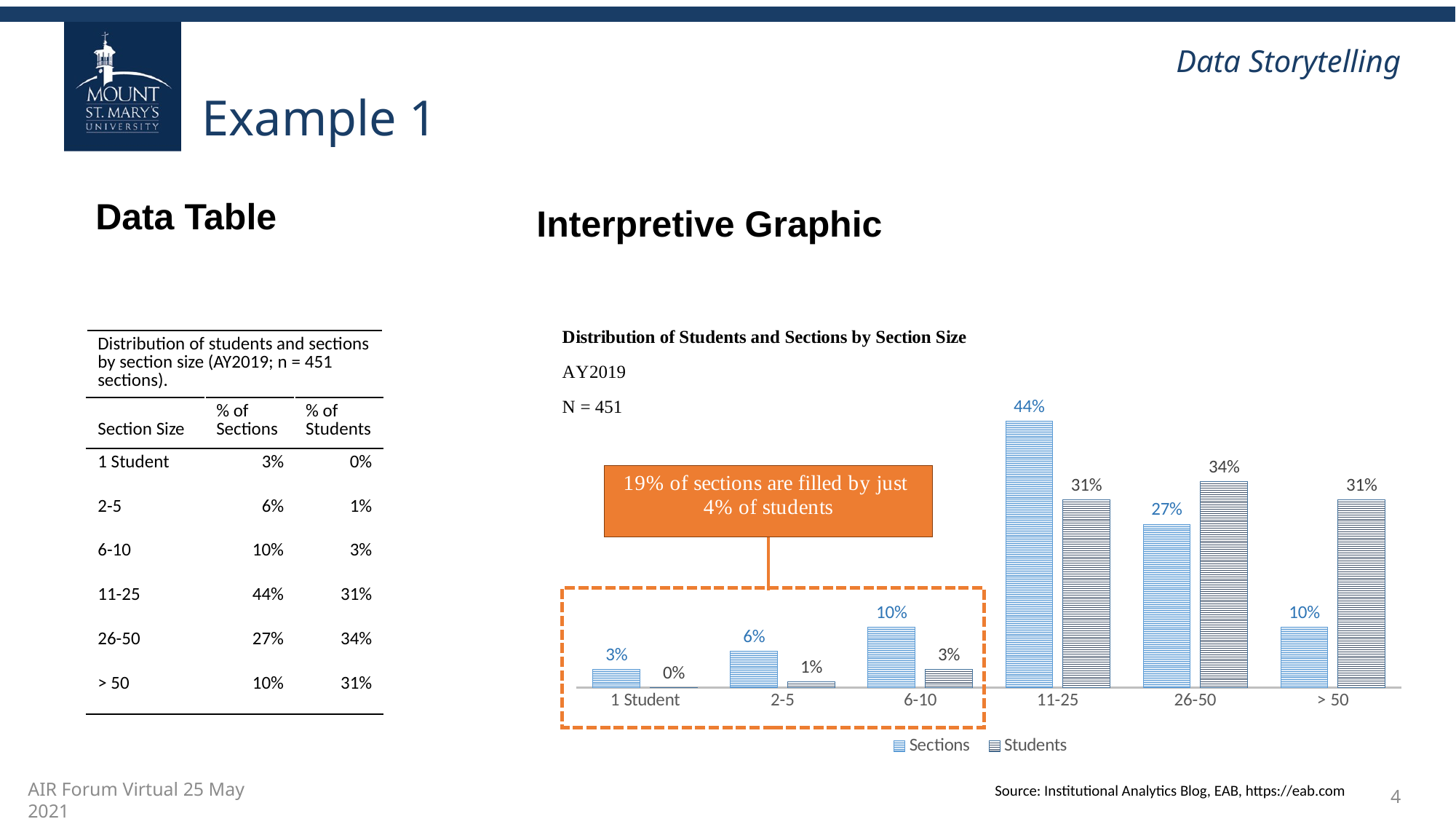
For the > 50 section size, which is larger: the percentage of sections or the percentage of students? Students What is the title of the chart? Distribution of Students and Sections by Section Size What is the difference between the percentage of sections and the percentage of students for the 11-25 section size? 13% How many series does the chart legend list? 2 What does the orange callout box on the chart say? 19% of sections are filled by just 4% of students What kind of chart is shown under Interpretive Graphic? Bar chart How many section size categories are shown on the x axis of the chart? 6 Which section size has the highest percentage of sections? 11-25 Which section size has the lowest percentage of students? 1 Student What percentage of students are in sections of size 26-50? 34% What percentage of sections have a section size of 11-25? 44% What percentage of students are in sections with 1 student? 0%